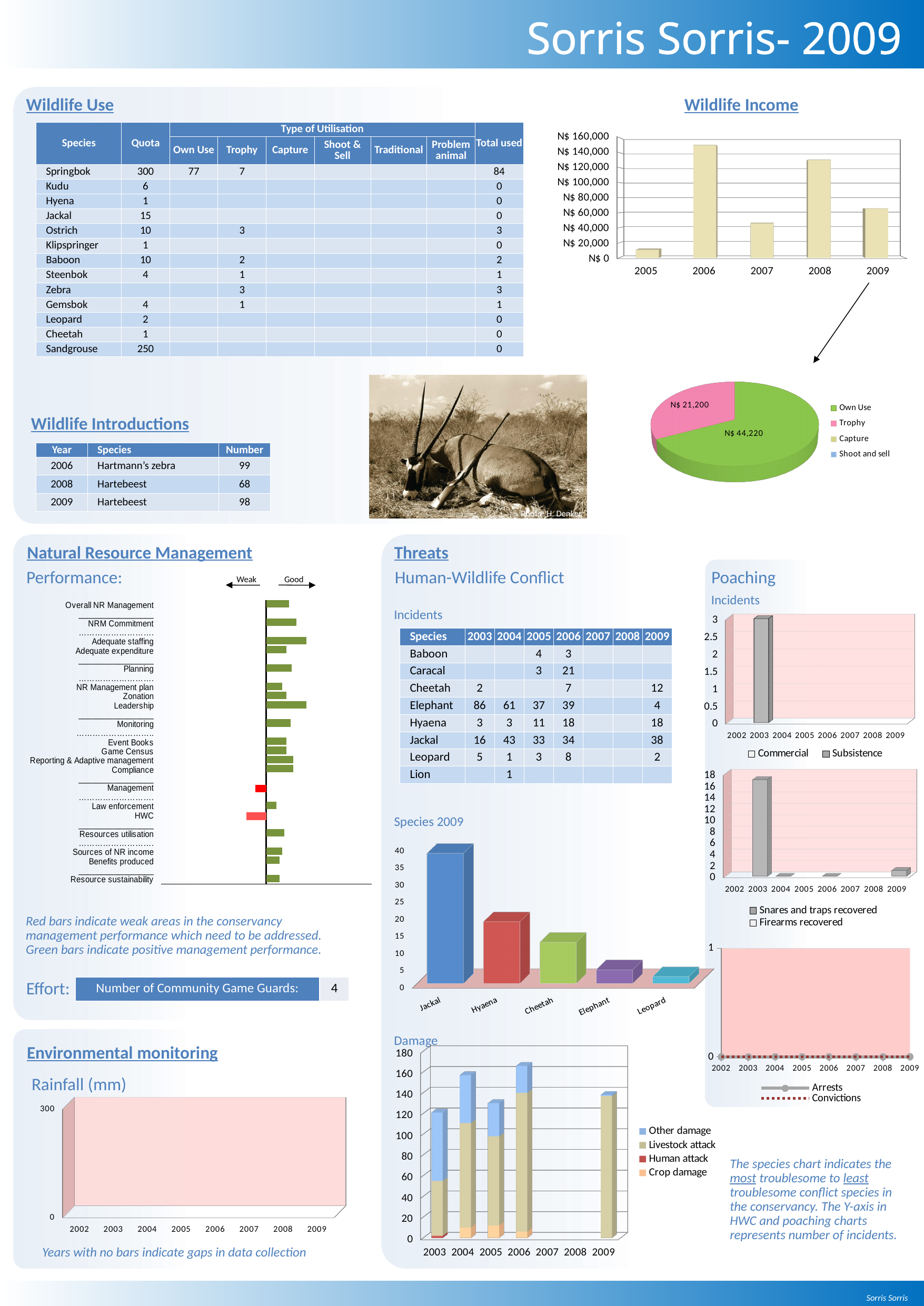
In the Wildlife Income chart, is the value for 2007 greater or less than N$ 60,000? less In the Wildlife Income chart, which year has the highest income? 2006 How many entries does the legend of the Wildlife Income pie chart list? 4 In the Poaching Incidents chart, what is the value for 2003? 3 In the Wildlife Income pie chart, what is the value for Trophy? N$ 21,200 In the Wildlife Income chart, which year has the lowest income? 2005 In the Species 2009 chart under Human-Wildlife Conflict, which species has the lowest number of incidents? Leopard In the Wildlife Income pie chart, what is the value for Own Use? N$ 44,220 In the Species 2009 chart under Human-Wildlife Conflict, which species has the highest number of incidents? Jackal In the Wildlife Income chart, is the value for 2008 greater or less than N$ 100,000? greater How many years are shown on the x axis of the Wildlife Income chart? 5 How many series does the legend of the Damage chart list? 4